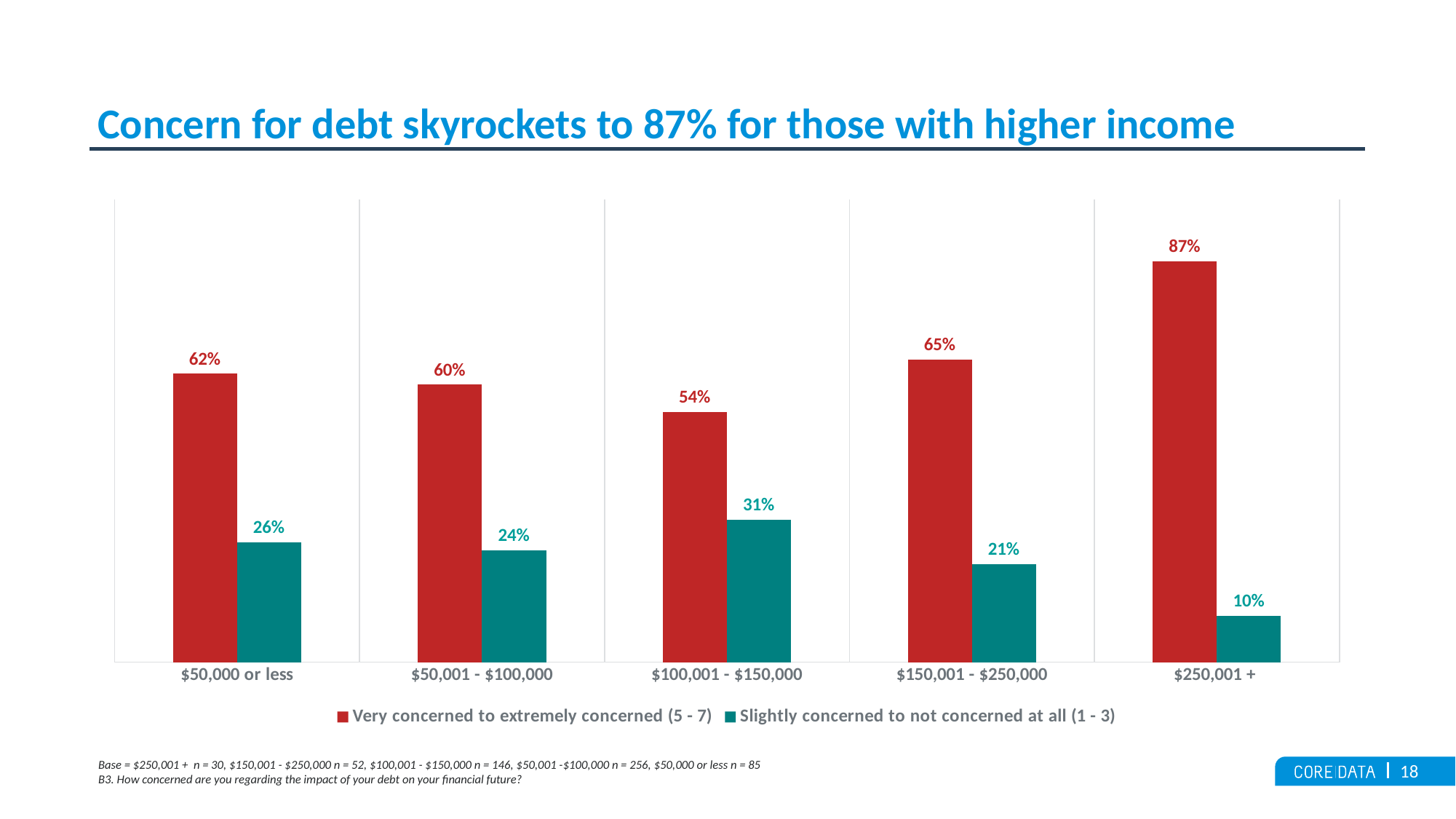
Which income group has the lowest share of 'Slightly concerned to not concerned at all (1 - 3)'? $250,001 + What percentage of those earning $100,001 - $150,000 are slightly concerned to not concerned at all (1 - 3)? 31% What is the value for 'Very concerned to extremely concerned (5 - 7)' in the $50,001 - $100,000 income group? 60% How many income groups are shown on the x axis? 5 What is the difference between the 'Very concerned to extremely concerned (5 - 7)' values for $250,001 + and $150,001 - $250,000? 22 percentage points Which is larger: the 'Slightly concerned to not concerned at all (1 - 3)' value for $50,000 or less, or for $50,001 - $100,000? $50,000 or less How many series does the legend list? 2 Which income group has the highest share of 'Very concerned to extremely concerned (5 - 7)'? $250,001 + What kind of chart is shown on the slide? Bar chart What percentage of those earning $250,001 + are very concerned to extremely concerned (5 - 7)? 87% Which income group has the lowest share of 'Very concerned to extremely concerned (5 - 7)'? $100,001 - $150,000 What colour represents 'Slightly concerned to not concerned at all (1 - 3)' in the chart? Teal